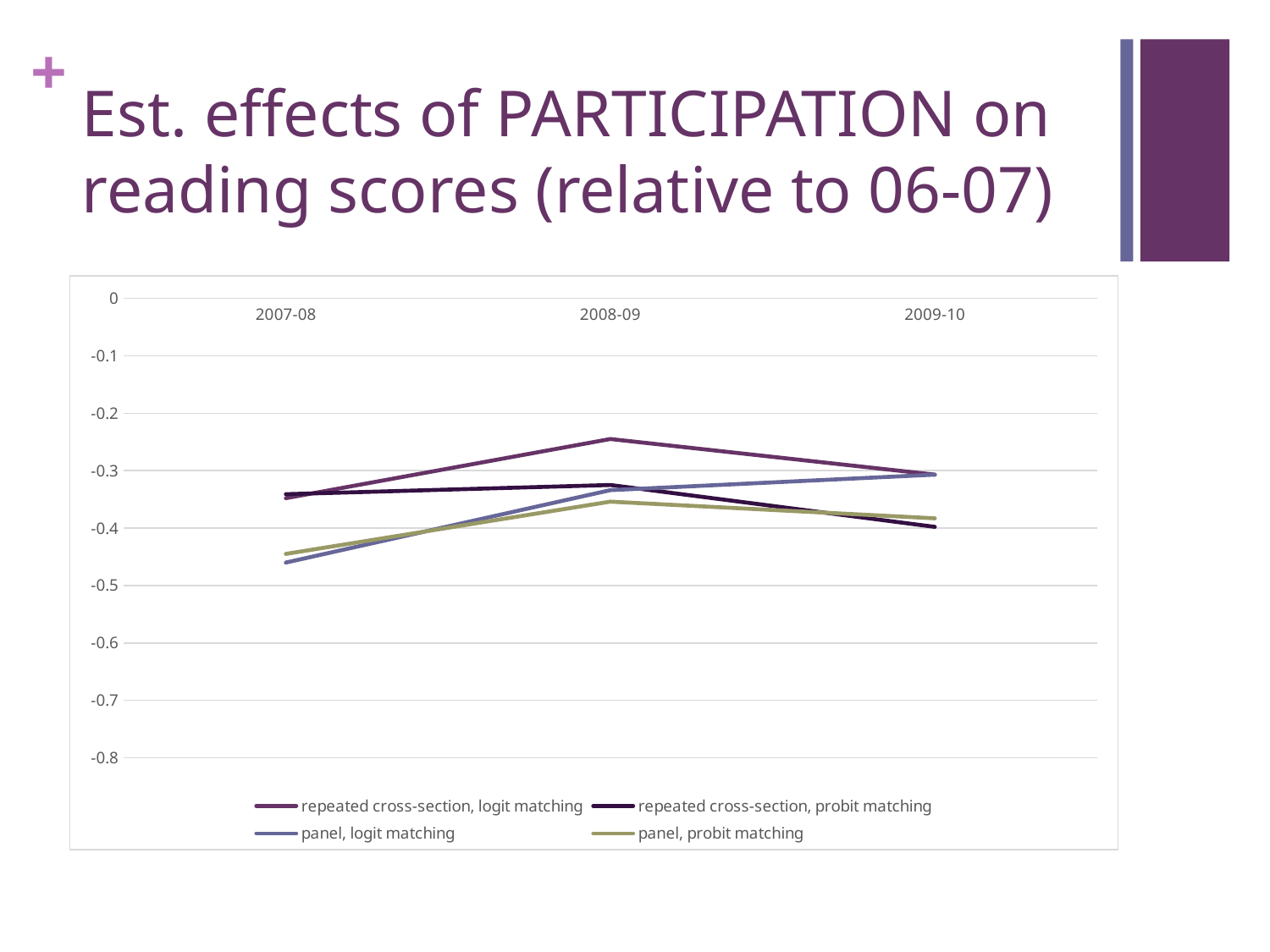
In 2007-08, which is larger: the value for repeated cross-section, logit matching or the value for panel, logit matching? repeated cross-section, logit matching Does the panel, logit matching line rise or fall from 2007-08 to 2009-10? rise What is the title of the slide containing the chart? Est. effects of PARTICIPATION on reading scores (relative to 06-07) Which series has the highest value in 2008-09? repeated cross-section, logit matching Is the value for repeated cross-section, probit matching in 2009-10 greater or less than -0.3? less What kind of chart is shown on the slide? line chart Is the value for panel, logit matching in 2007-08 greater or less than -0.4? less What is the lowest value shown on the y axis? -0.8 How many series does the legend list? 4 Is the value for repeated cross-section, logit matching in 2008-09 greater or less than -0.3? greater How many school years are shown on the x axis? 3